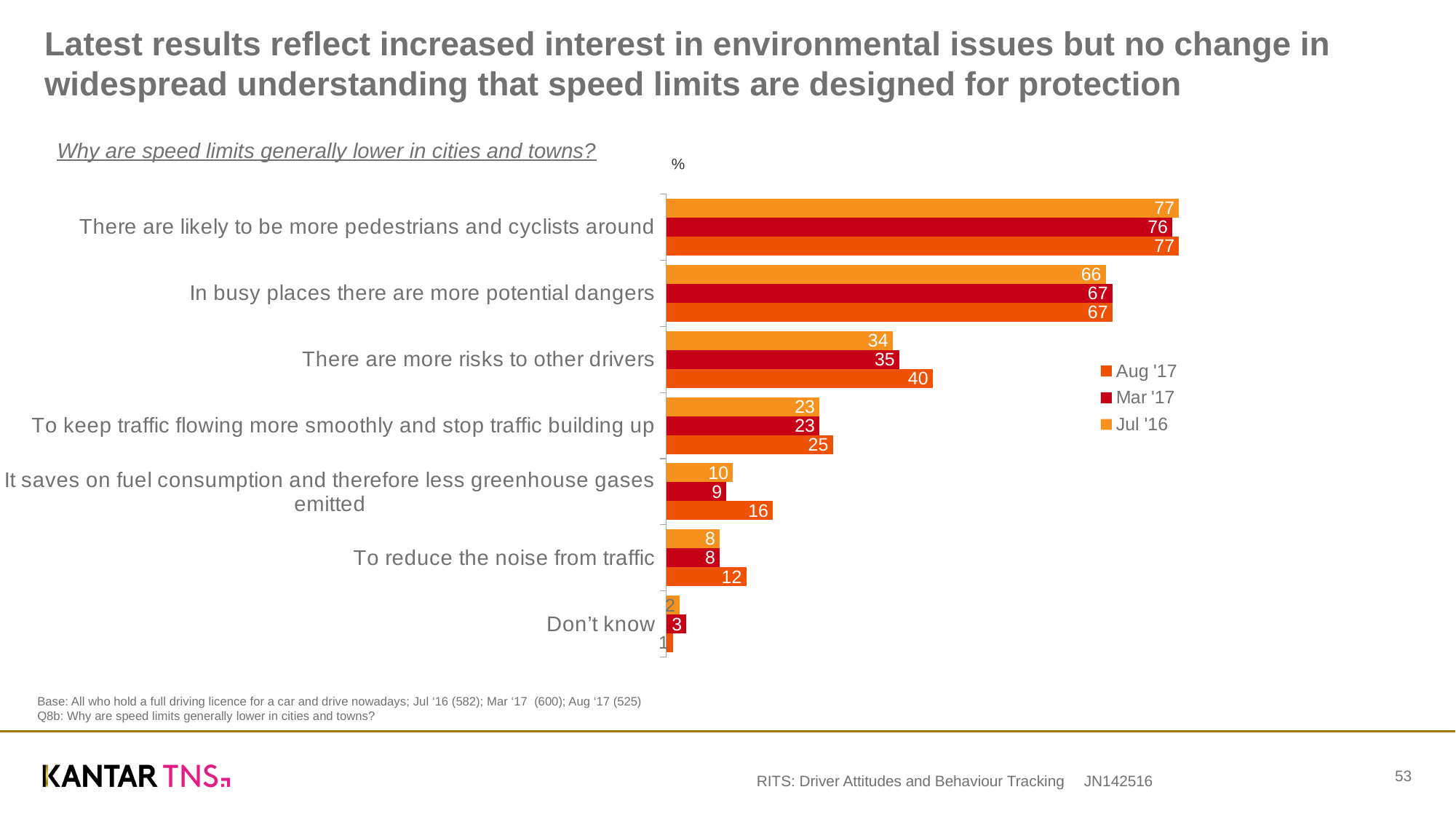
Which series is listed first in the legend? Aug '17 How many response categories are shown on the chart? 7 What kind of chart is shown on the slide? bar chart What is the difference between the Aug '17 and Mar '17 values for 'There are more risks to other drivers'? 5 What is the Aug '17 value for 'It saves on fuel consumption and therefore less greenhouse gases emitted'? 16 What is the Jul '16 value for 'To reduce the noise from traffic'? 8 Which response has the lowest Aug '17 value? Don't know For 'To reduce the noise from traffic', which is larger: the Aug '17 value or the Mar '17 value? Aug '17 How many series does the legend list? 3 Which response has the highest Aug '17 value? There are likely to be more pedestrians and cyclists around What is the difference between the Aug '17 and Jul '16 values for 'It saves on fuel consumption and therefore less greenhouse gases emitted'? 6 What is the Mar '17 value for 'There are more risks to other drivers'? 35